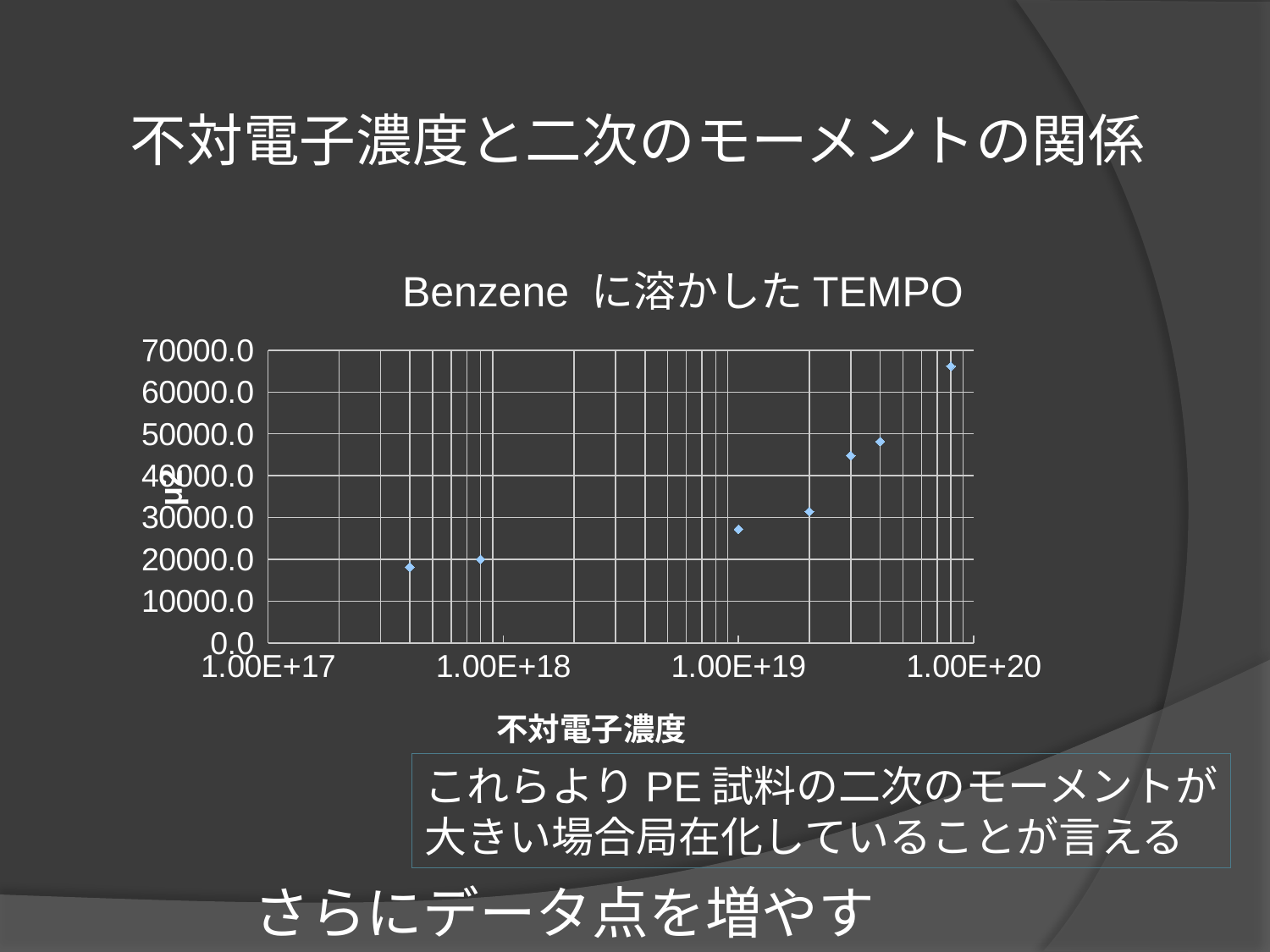
What is the highest value shown on the y axis? 70000.0 Is the value of the lowest data point greater or less than 10000.0? greater What kind of chart is shown on the slide? scatter chart Is the value of the data point plotted just below 1.00E+19 on the x axis greater or less than 20000.0? greater Is the value of the data point plotted just below 1.00E+19 on the x axis greater or less than 30000.0? less Do the plotted values rise or fall as the x axis (不対電子濃度) increases? rise How many data points are plotted in the chart? 7 What is the title of the chart? Benzene に溶かした TEMPO What is the rightmost tick label on the x axis? 1.00E+20 Which data point has the highest value: the one nearest 1.00E+20 or the one nearest 1.00E+18? the one nearest 1.00E+20 What is the label of the x axis? 不対電子濃度